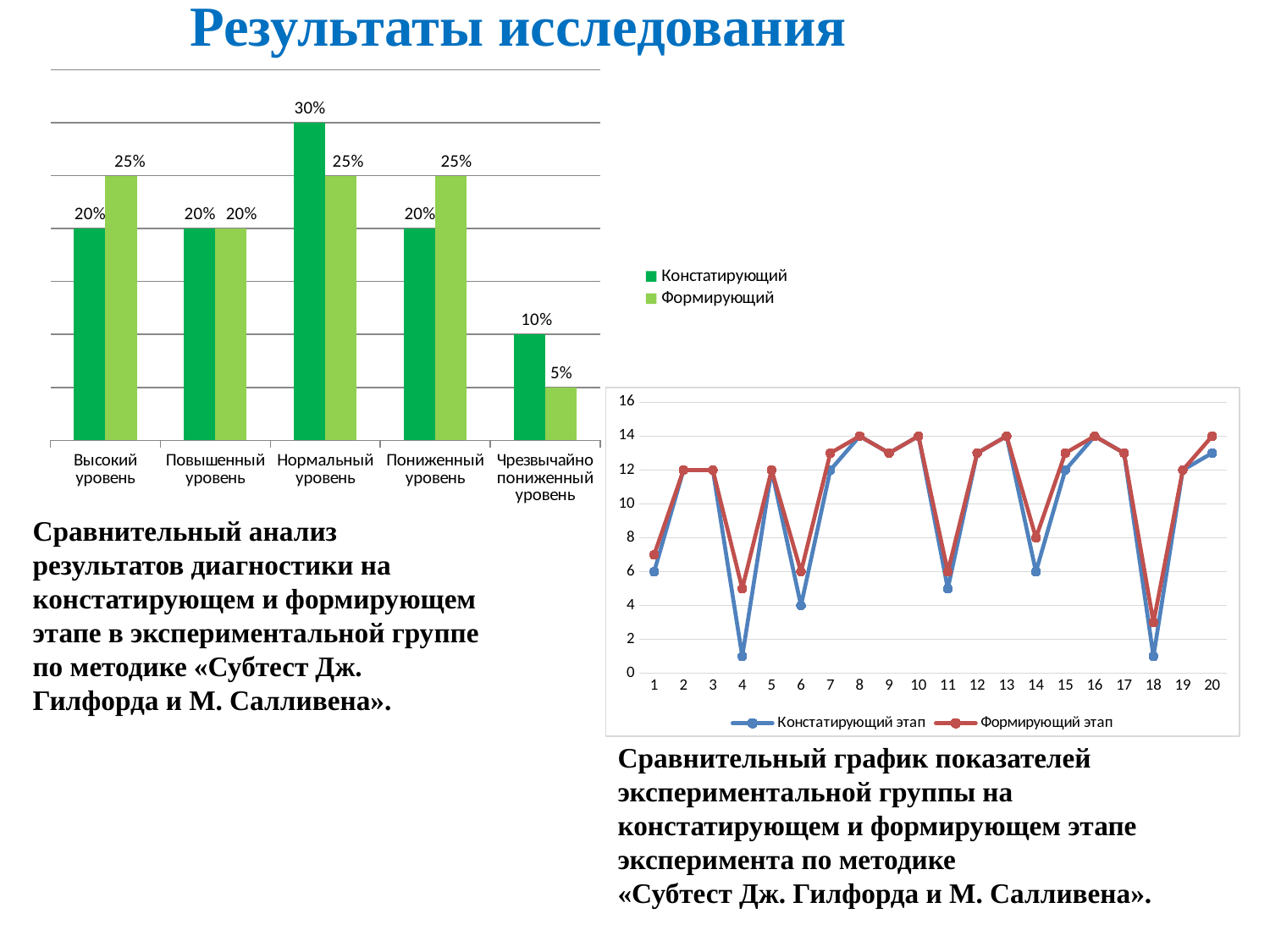
How many categories does the bar chart on the left show? 5 In the bar chart on the left, which category has the highest Констатирующий value? Нормальный уровень What kind of chart is the chart on the right? Line chart In the bar chart on the left, what is the value for Формирующий at Чрезвычайно пониженный уровень? 5% How many series does the legend of the bar chart on the left list? 2 In the bar chart on the left, which category has the lowest Формирующий value? Чрезвычайно пониженный уровень In the line chart on the right, what is the value for Формирующий этап at point 8? 14 How many points are plotted along the x axis of the line chart on the right? 20 In the bar chart on the left, what is the value for Констатирующий at Нормальный уровень? 30% In the bar chart on the left, what is the difference between the Констатирующий and Формирующий values at Высокий уровень? 5% In the line chart on the right, is the value for Констатирующий этап at point 4 greater or less than 2? less In the bar chart on the left, which is larger at Пониженный уровень: Констатирующий or Формирующий? Формирующий